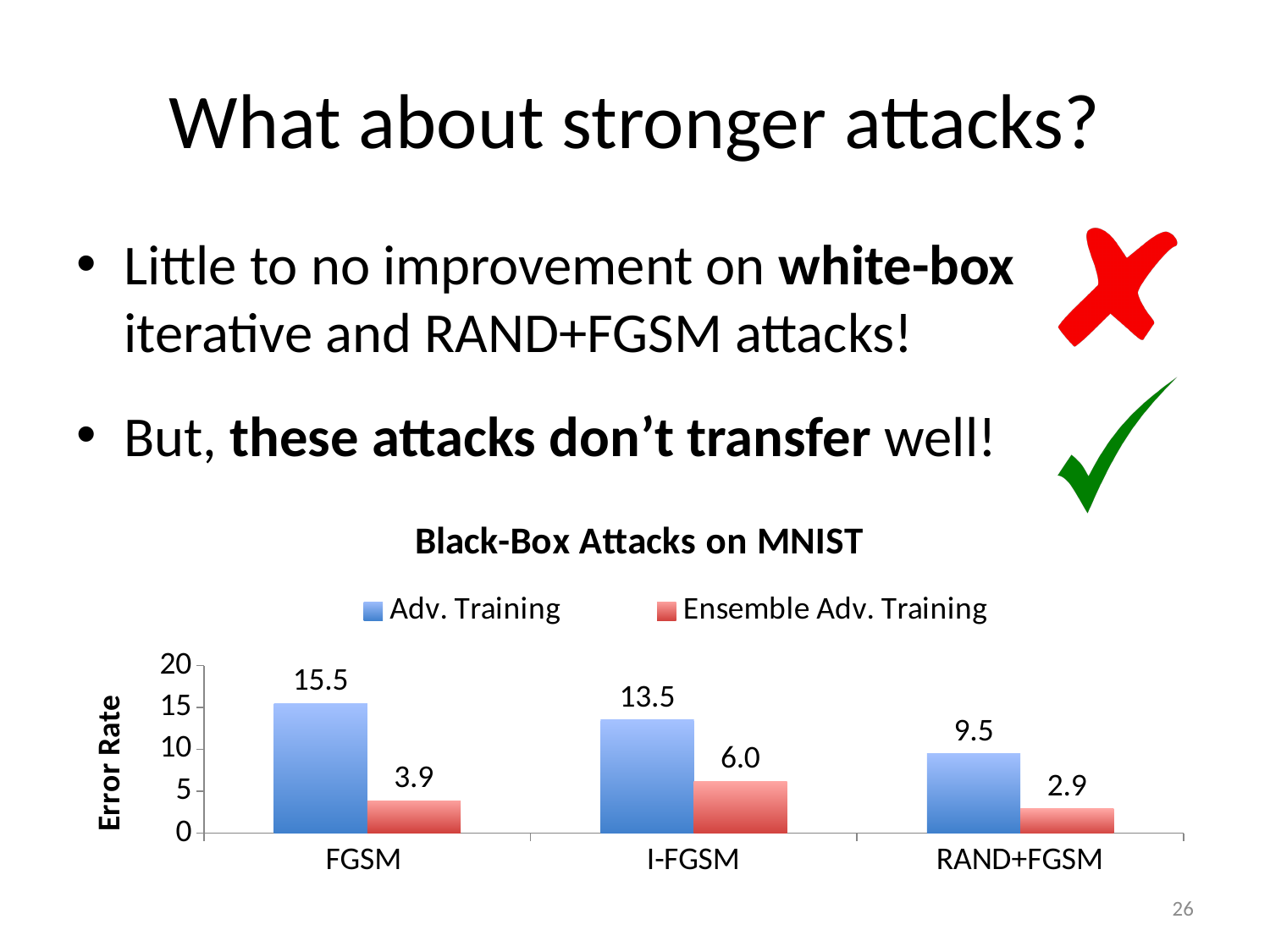
What is the error rate for Ensemble Adv. Training under the RAND+FGSM attack? 2.9 What is the error rate for Adv. Training under the FGSM attack? 15.5 Which attack gives the highest error rate for Adv. Training? FGSM What is the difference between the Adv. Training and Ensemble Adv. Training error rates under the FGSM attack? 11.6 Under the I-FGSM attack, which series has the larger error rate, Adv. Training or Ensemble Adv. Training? Adv. Training Is the Adv. Training error rate under RAND+FGSM greater or less than 10? less What is the error rate for Ensemble Adv. Training under the I-FGSM attack? 6.0 How many attack categories are shown on the x axis? 3 How many series does the legend list? 2 Which attack gives the lowest error rate for Ensemble Adv. Training? RAND+FGSM What is the title of the chart? Black-Box Attacks on MNIST What kind of chart is shown on the slide? bar chart